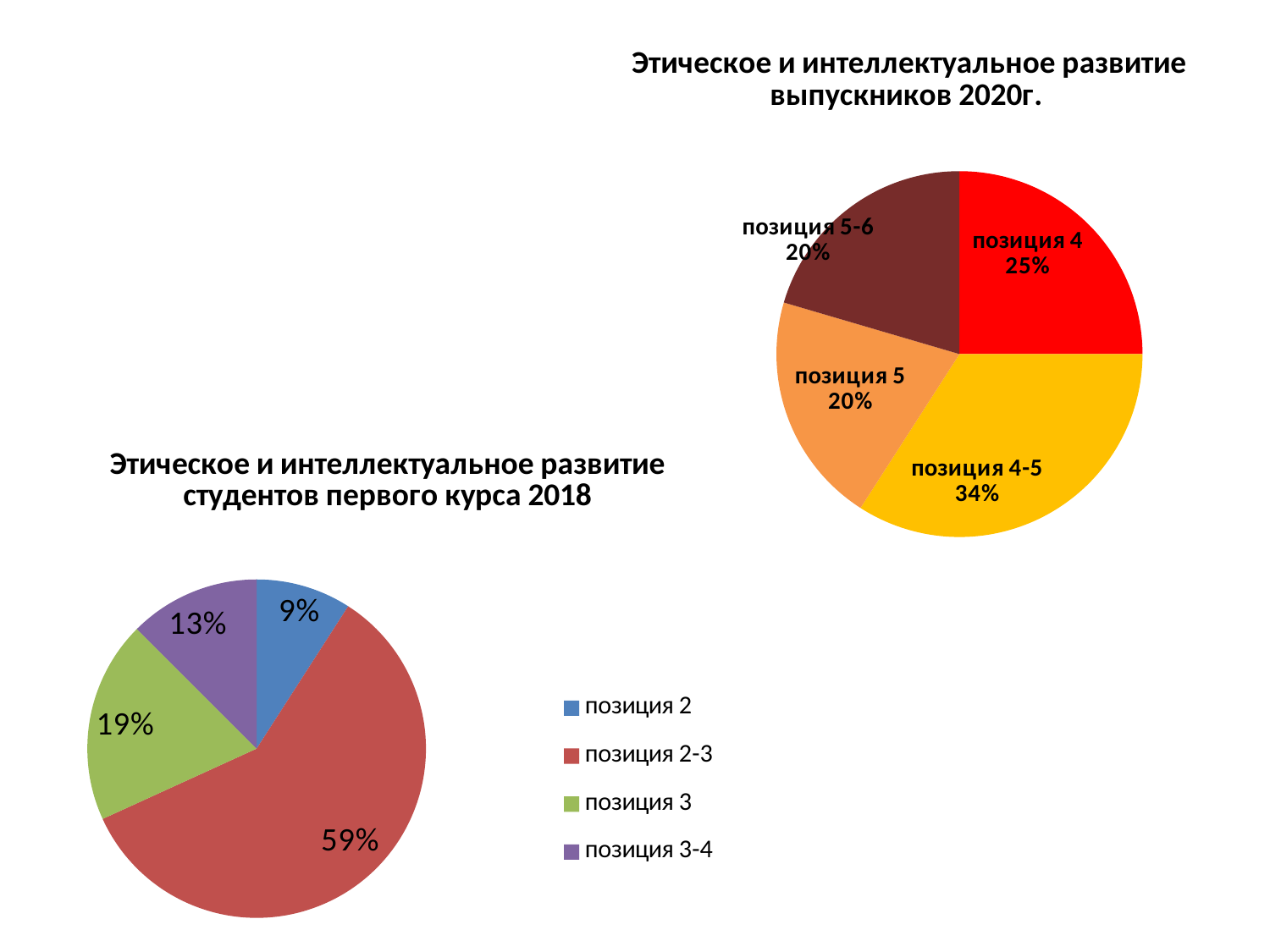
In the chart titled 'Этическое и интеллектуальное развитие выпускников 2020г.', what share does 'позиция 4-5' have? 34% In the chart titled 'Этическое и интеллектуальное развитие студентов первого курса 2018', what share does 'позиция 2-3' have? 59% In the chart titled 'Этическое и интеллектуальное развитие студентов первого курса 2018', what is the difference between 'позиция 2-3' and 'позиция 2'? 50% In the chart titled 'Этическое и интеллектуальное развитие выпускников 2020г.', what share does 'позиция 4' have? 25% In the chart titled 'Этическое и интеллектуальное развитие студентов первого курса 2018', how many entries does the legend list? 4 In the chart titled 'Этическое и интеллектуальное развитие выпускников 2020г.', what is the difference between 'позиция 4-5' and 'позиция 5'? 14% What kind of chart is the one titled 'Этическое и интеллектуальное развитие студентов первого курса 2018'? Pie chart In the chart titled 'Этическое и интеллектуальное развитие выпускников 2020г.', how many slices does the pie have? 4 In the chart titled 'Этическое и интеллектуальное развитие выпускников 2020г.', which slice is the largest? позиция 4-5 In the chart titled 'Этическое и интеллектуальное развитие студентов первого курса 2018', which slice is the smallest? позиция 2 In the chart titled 'Этическое и интеллектуальное развитие студентов первого курса 2018', what share does 'позиция 3' have? 19% In the chart titled 'Этическое и интеллектуальное развитие студентов первого курса 2018', which is larger: 'позиция 3' or 'позиция 3-4'? позиция 3